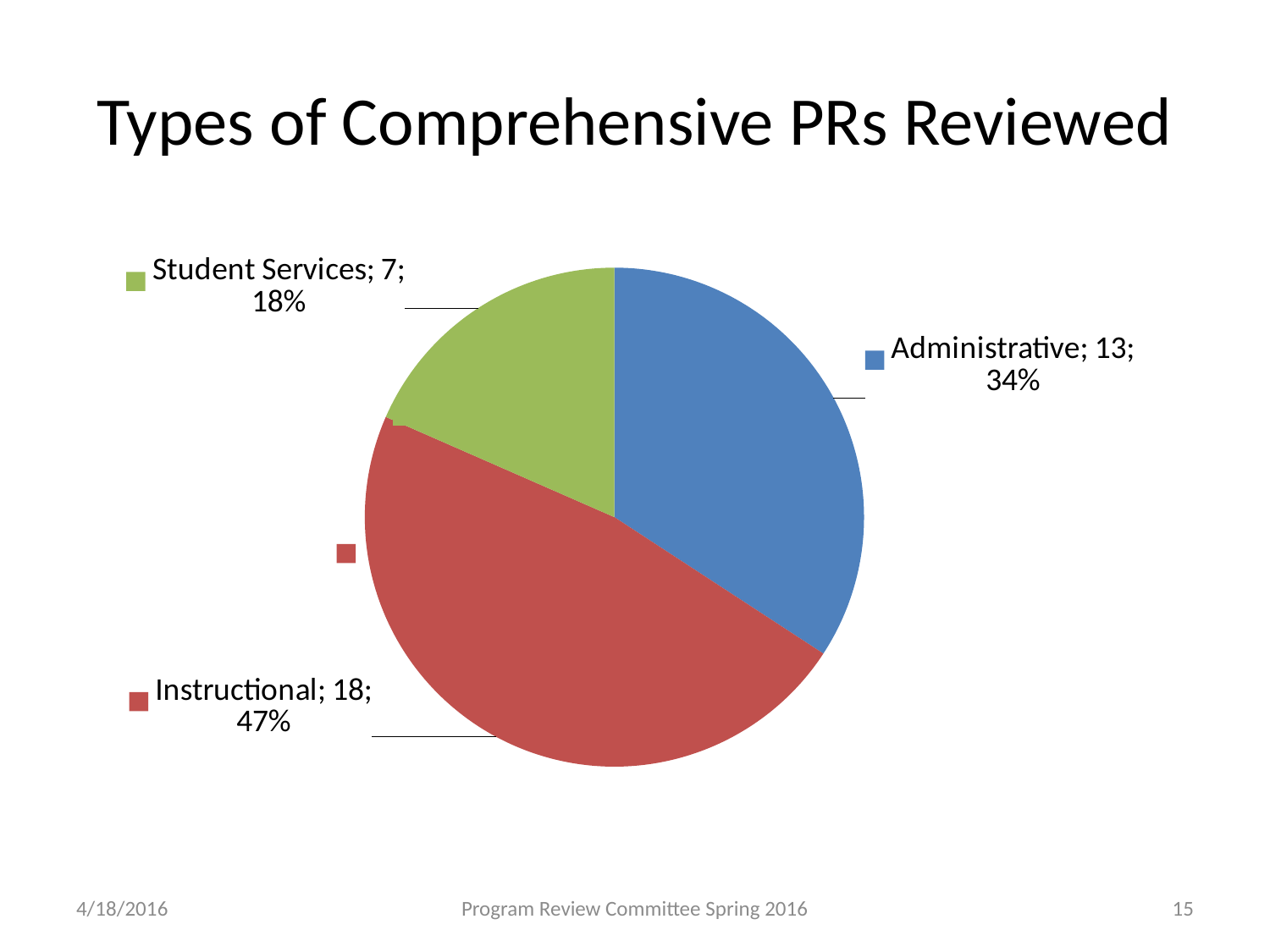
How many comprehensive PRs reviewed were Student Services? 7 What share of the pie does the Instructional slice represent? 47% How many categories are shown in the pie chart? 3 What kind of chart is shown on the slide? pie chart Which type of comprehensive PR has the largest slice? Instructional How many comprehensive PRs reviewed were Administrative? 13 Which type of comprehensive PR has the smallest slice? Student Services How many comprehensive PRs reviewed were Instructional? 18 What share of the pie does the Administrative slice represent? 34% What is the difference between the number of Instructional and Administrative PRs reviewed? 5 What share of the pie does the Student Services slice represent? 18% Which is larger, the Administrative count or the Student Services count? Administrative